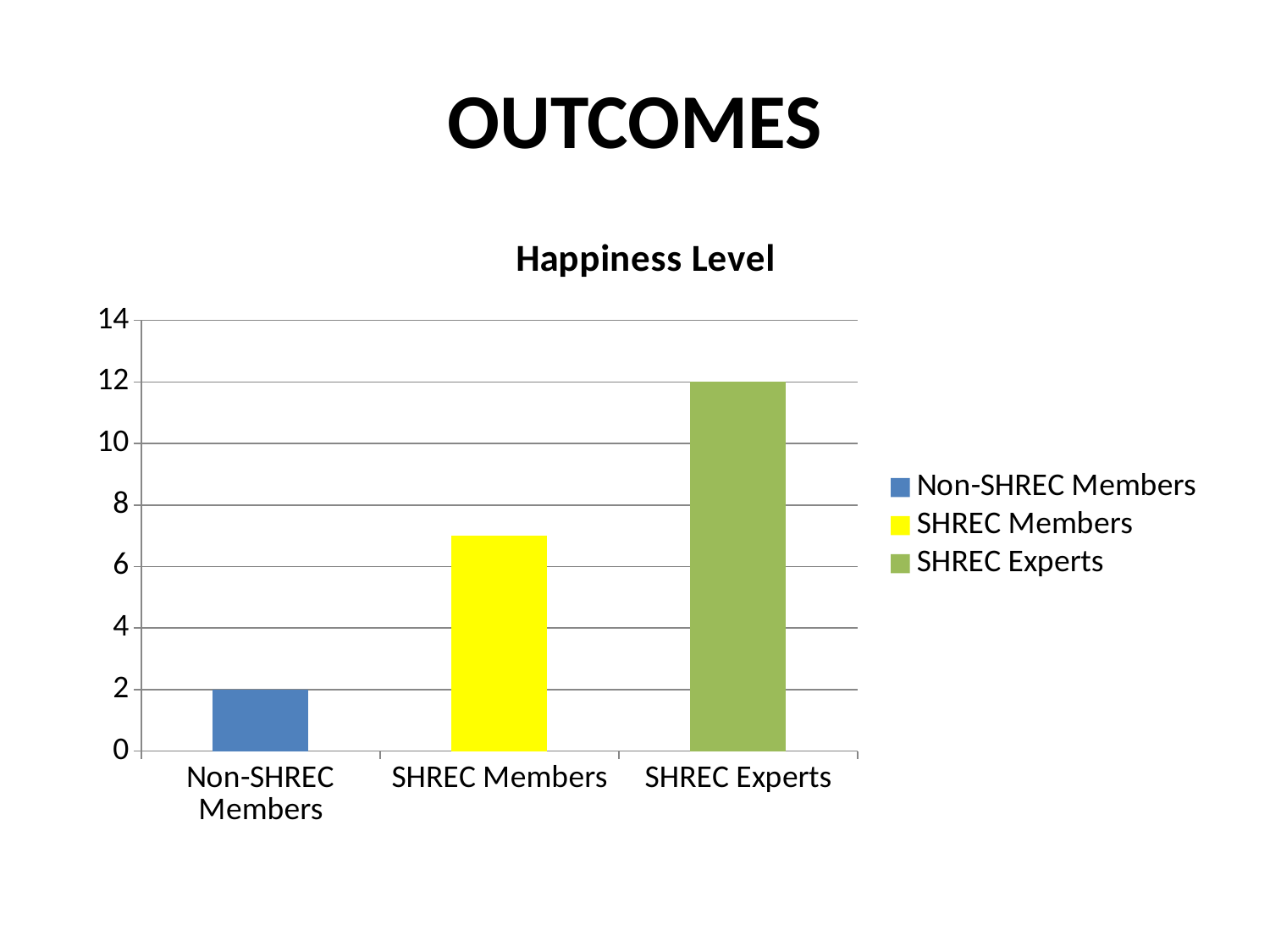
How many categories are shown on the x axis? 3 What is the value for Non-SHREC Members? 2 Which is larger, the value for SHREC Members or the value for Non-SHREC Members? SHREC Members What is the value for SHREC Experts? 12 What type of chart is shown on the slide? bar chart What is the title of the chart? Happiness Level Which category has the lowest value? Non-SHREC Members Is the value for SHREC Members greater or less than 6? greater What is the difference between the values for SHREC Experts and Non-SHREC Members? 10 How many entries does the legend list? 3 Do the values rise or fall from left to right along the x axis? rise Which category has the highest value? SHREC Experts